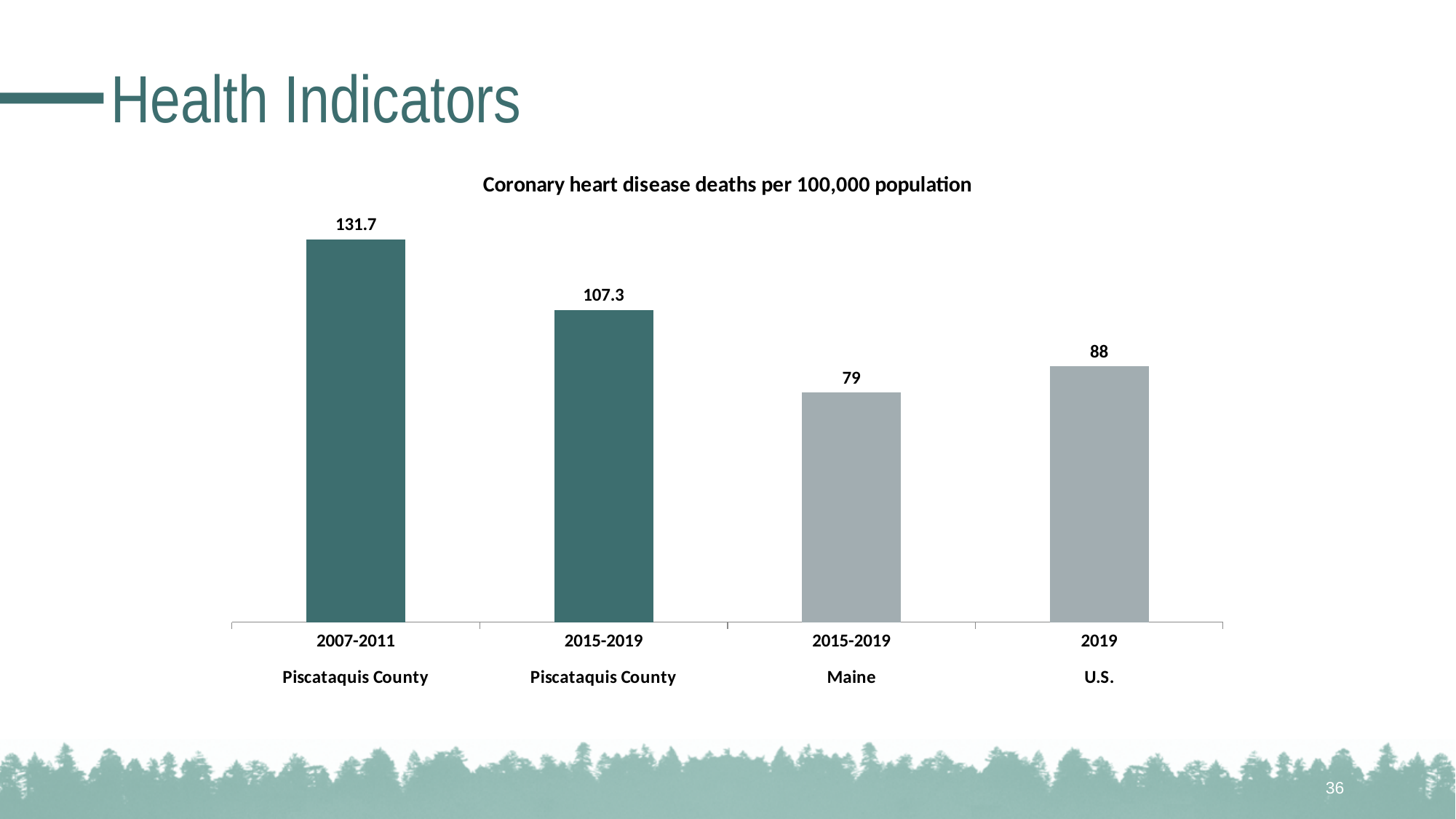
Which category has the lowest value? 2015-2019 Maine What is the value for Piscataquis County in 2007-2011? 131.7 What is the difference between the U.S. 2019 value and the Maine 2015-2019 value? 9 Which category has the highest value? 2007-2011 Piscataquis County What kind of chart is shown on the slide? Bar chart How many bars are shown in the chart? 4 What is the title of the chart? Coronary heart disease deaths per 100,000 population Which is larger, the value for Piscataquis County in 2015-2019 or the value for the U.S. in 2019? Piscataquis County in 2015-2019 What is the difference between the Piscataquis County values for 2007-2011 and 2015-2019? 24.4 What is the value for the U.S. in 2019? 88 What is the value for Piscataquis County in 2015-2019? 107.3 What is the value for Maine in 2015-2019? 79